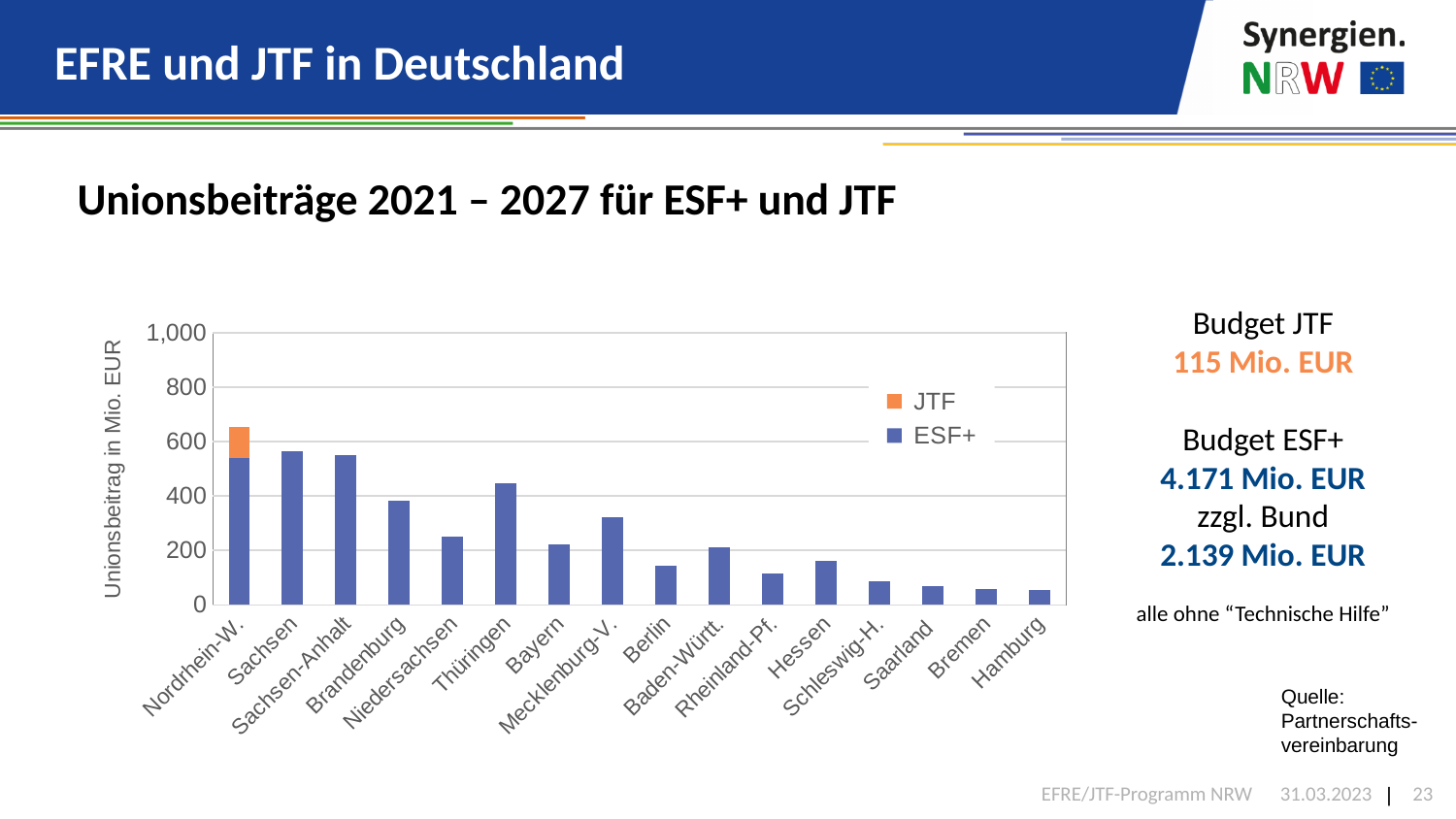
Is the value for Sachsen greater or less than 400? greater Do the bar values generally rise or fall from left to right along the x axis? fall How many federal states (categories) are shown on the x axis of the chart? 16 How many series does the chart legend list? 2 Which series is shown in orange in the chart legend? JTF What kind of chart is shown on the slide? Stacked bar chart Which has the larger bar, Thüringen or Mecklenburg-V.? Thüringen Which federal state has the highest total bar in the chart? Nordrhein-W. Is the value for Hamburg greater or less than 200? less Is the value for Niedersachsen greater or less than 400? less Which has the larger bar, Brandenburg or Niedersachsen? Brandenburg